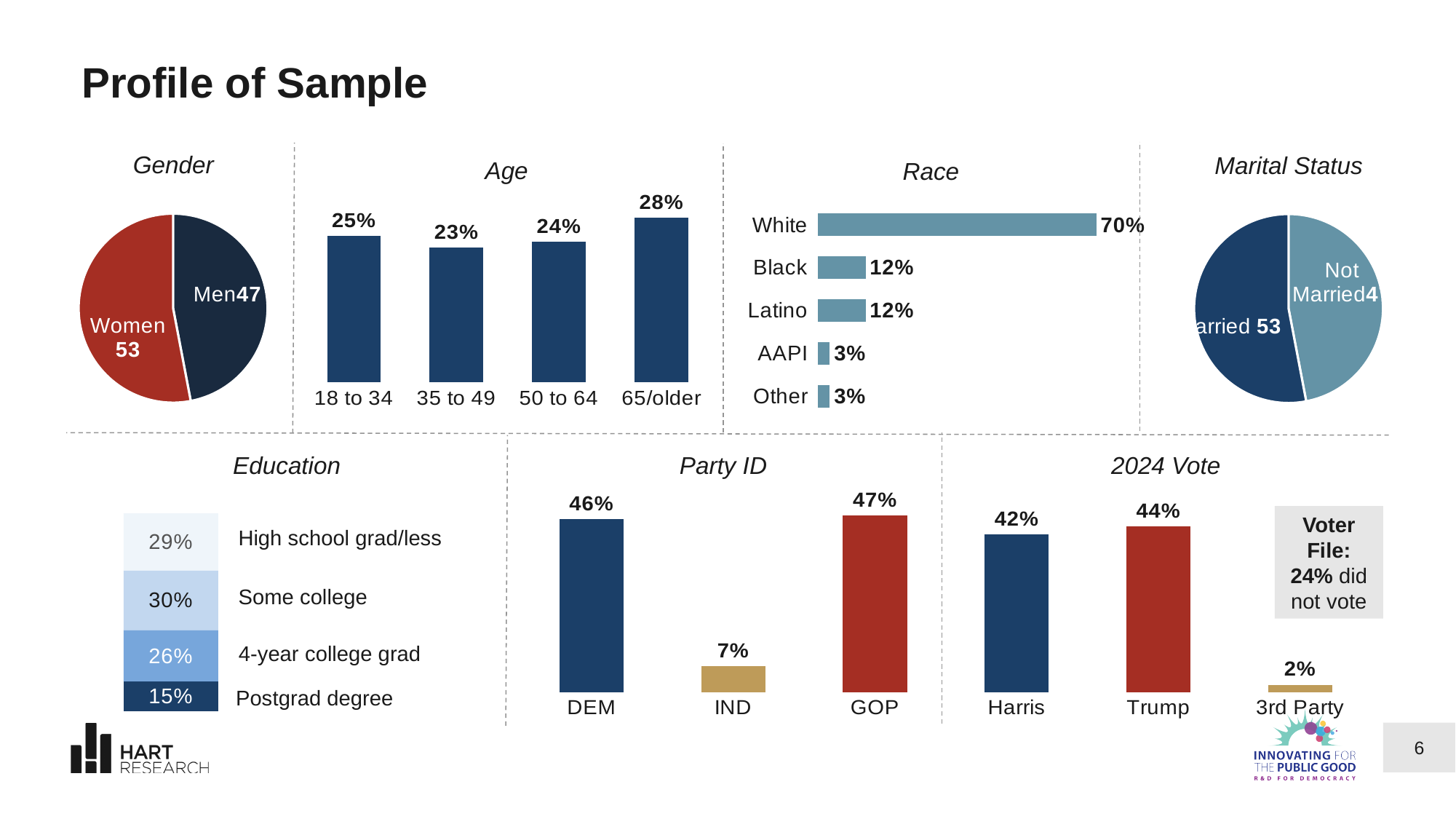
In the Age chart, which age group has the lowest share? 35 to 49 In the Party ID chart, what is the difference between GOP and DEM? 1% In the Race chart, how many race categories are shown? 5 In the Education chart, which category has the largest share? Some college In the Gender pie chart, what is the value for Women? 53 In the 2024 Vote chart, which is larger, Harris or Trump? Trump In the Education chart, what share has a postgrad degree? 15% In the Age chart, what share of the sample is 65/older? 28% What type of chart is used for Marital Status? Pie chart In the Party ID chart, what is the value for IND? 7% In the Race chart, what is the value for White? 70% In the Race chart, what is the difference between the White and Black values? 58%